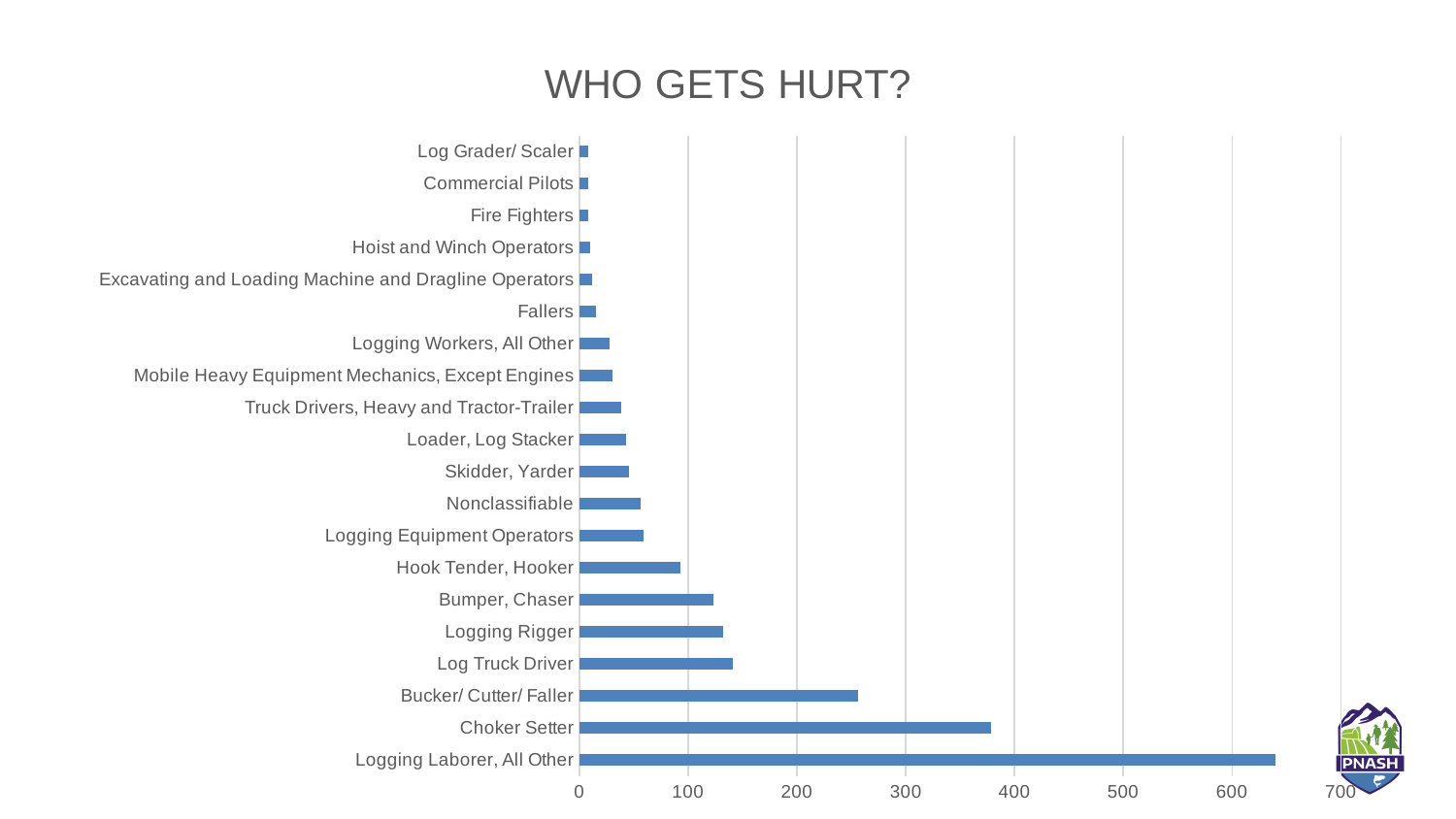
Which is larger, the value for Fallers or the value for Hook Tender, Hooker? Hook Tender, Hooker What is the highest value shown on the horizontal axis? 700 Is the value for Logging Laborer, All Other greater or less than 600? greater Is the value for Choker Setter greater or less than 400? less Is the value for Hook Tender, Hooker greater or less than 100? less How many categories are plotted in the chart? 20 What kind of chart is shown on the slide? bar chart What is the title of the chart? WHO GETS HURT? Which is larger, the value for Choker Setter or the value for Bucker/ Cutter/ Faller? Choker Setter Which category has the highest value? Logging Laborer, All Other